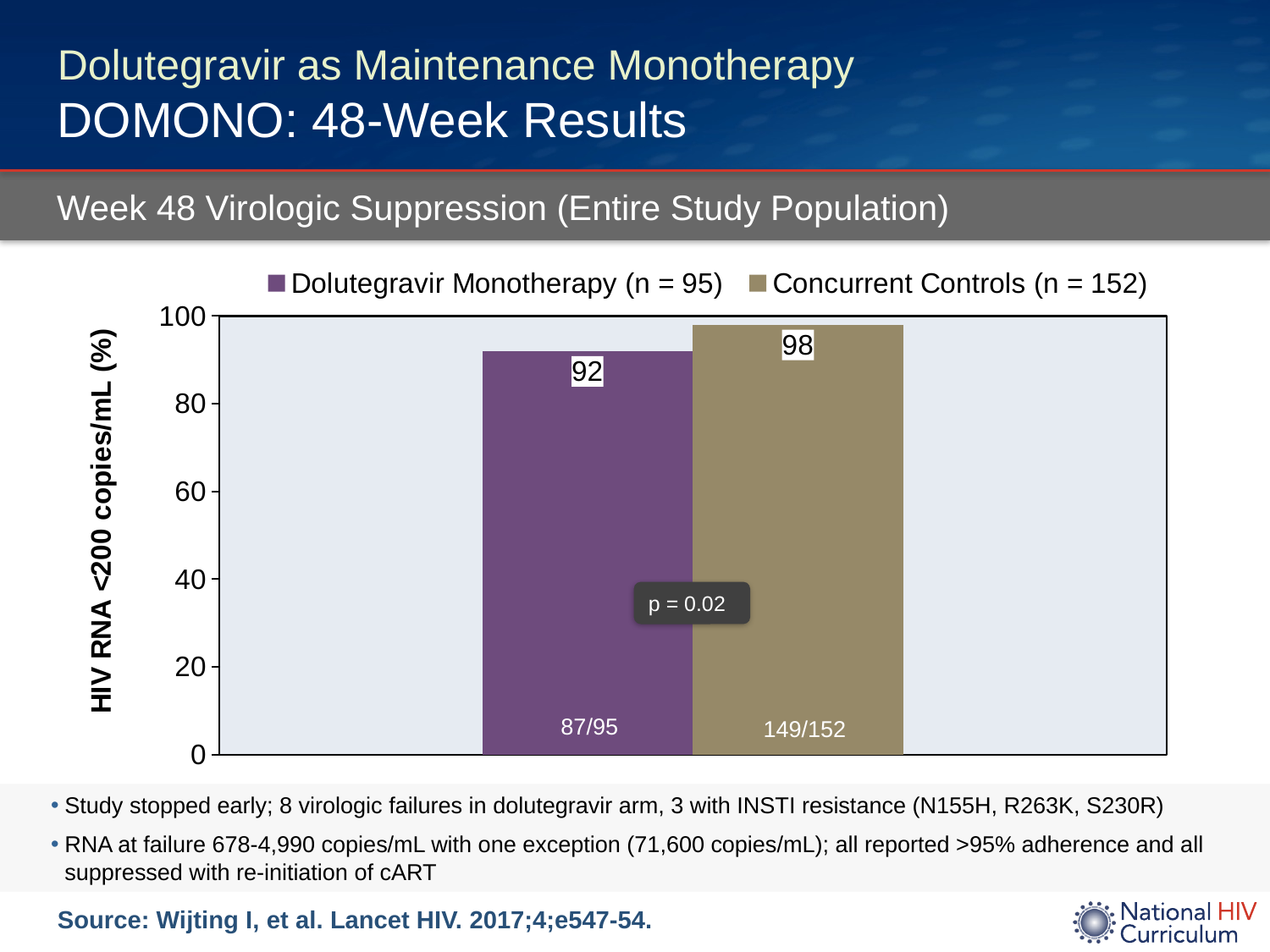
What is the y-axis label of the chart? HIV RNA <200 copies/mL (%) Which series has the lower value? Dolutegravir Monotherapy (n = 95) What p-value is shown on the chart? p = 0.02 What is the value for Dolutegravir Monotherapy (n = 95)? 92 Which series has the higher value? Concurrent Controls (n = 152) What is the value for Concurrent Controls (n = 152)? 98 What fraction is printed inside the Dolutegravir Monotherapy bar? 87/95 How many series does the legend list? 2 What is the difference between the Concurrent Controls value and the Dolutegravir Monotherapy value? 6 What fraction is printed inside the Concurrent Controls bar? 149/152 What kind of chart is shown? bar chart Is the value for Dolutegravir Monotherapy greater or less than 80? greater